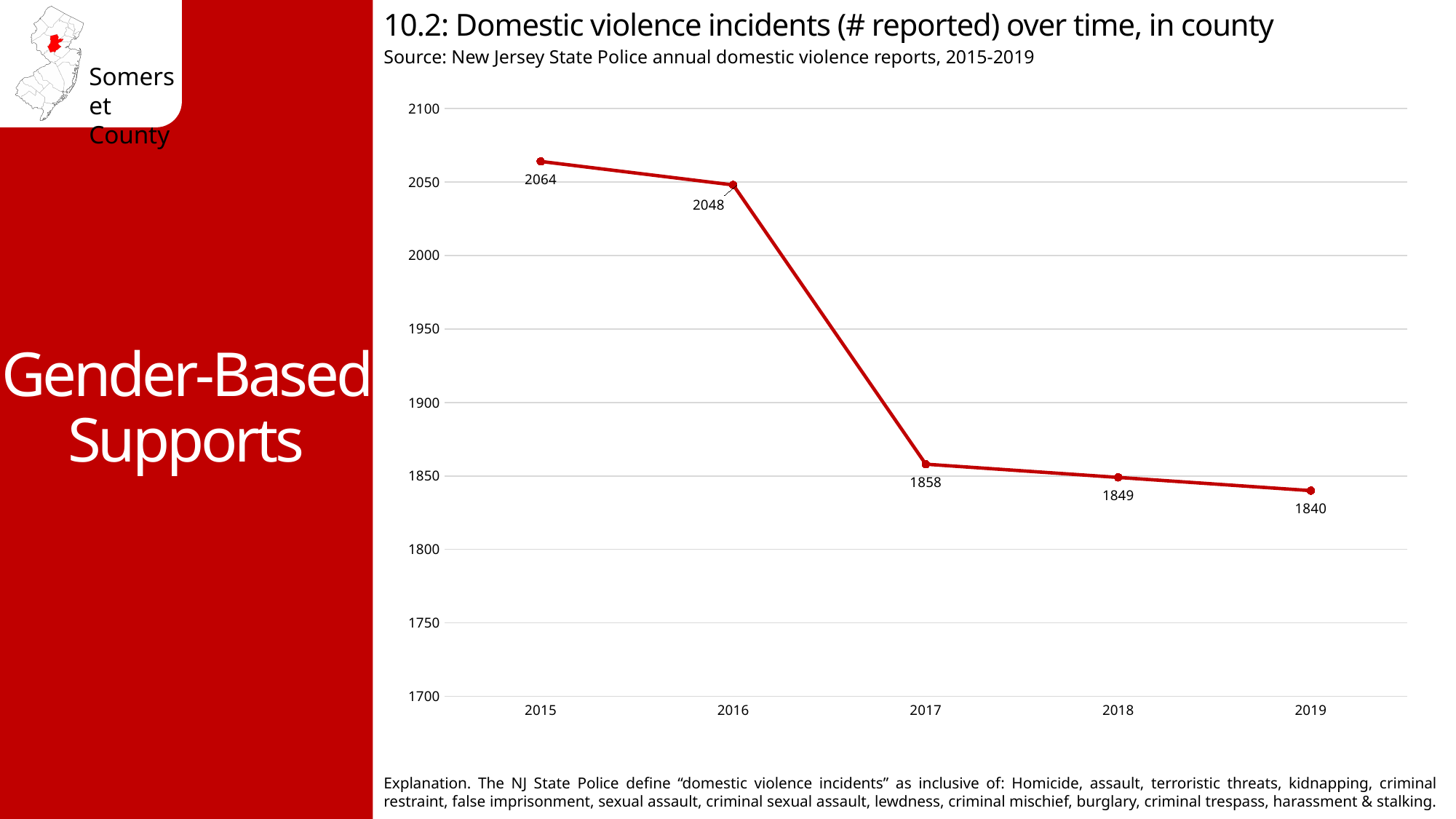
Which year had more reported incidents, 2016 or 2018? 2016 How many domestic violence incidents were reported in 2015? 2064 What kind of chart is shown on the slide? line chart Do the reported incidents rise or fall from 2015 to 2019? fall What is the difference in reported incidents between 2016 and 2017? 190 Is the value for 2018 greater or less than 1900? less How many domestic violence incidents were reported in 2017? 1858 How many domestic violence incidents were reported in 2019? 1840 Which year had the lowest number of reported domestic violence incidents? 2019 What is the difference in reported incidents between 2015 and 2019? 224 How many years are plotted on the chart? 5 Which year had the highest number of reported domestic violence incidents? 2015